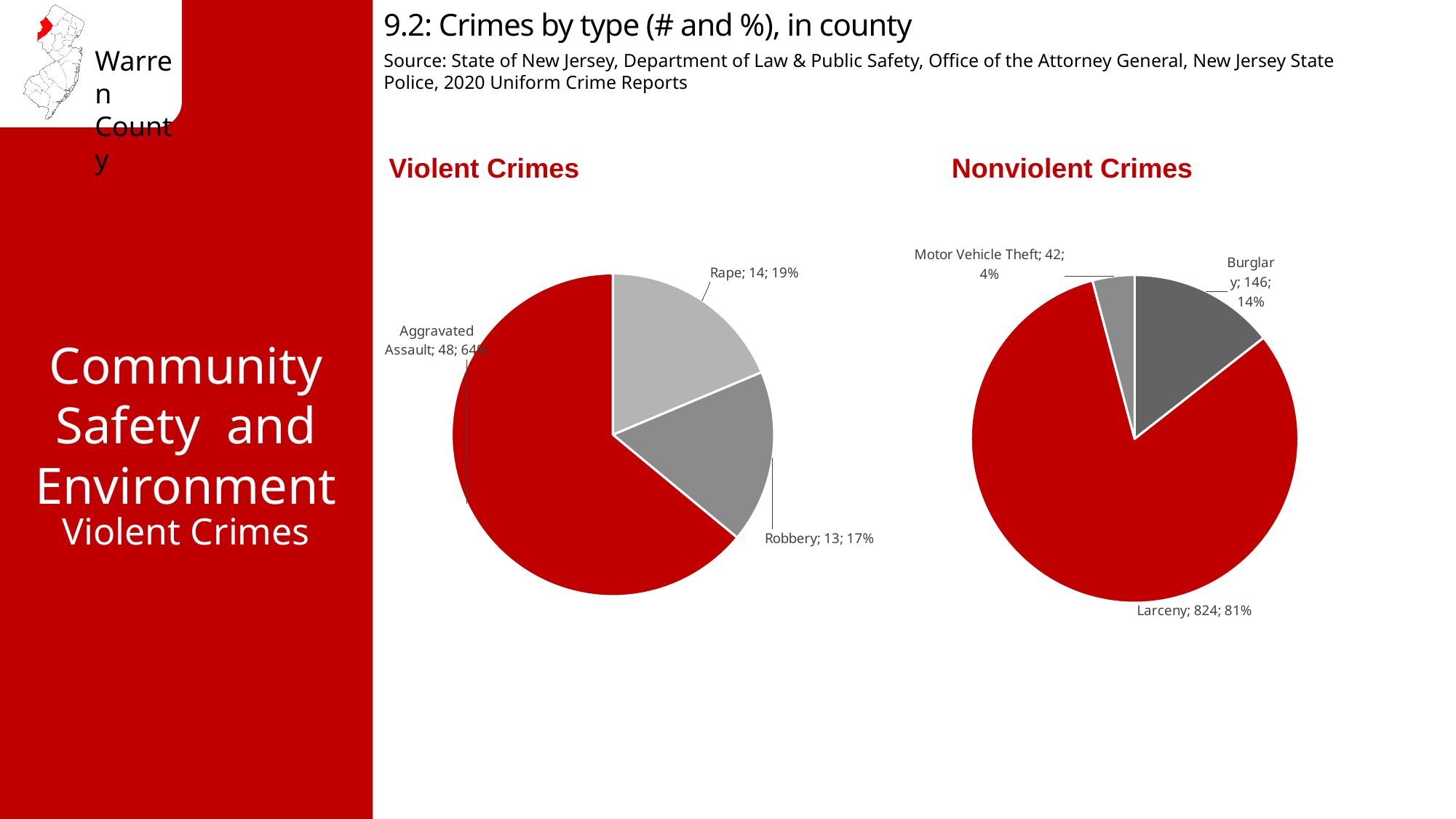
In the Nonviolent Crimes chart, which is larger, Burglary or Motor Vehicle Theft? Burglary What is the title of the chart on the right side of the slide? Nonviolent Crimes In the Nonviolent Crimes chart, what share of the pie is Burglary? 14% In the Violent Crimes chart, which category has the smallest slice? Robbery In the Nonviolent Crimes chart, which category has the largest slice? Larceny In the Nonviolent Crimes chart, what is the difference between the number of burglaries and the number of motor vehicle thefts? 104 In the Violent Crimes chart, what is the difference between the number of rapes and the number of robberies? 1 In the Nonviolent Crimes chart, how many larcenies are shown? 824 In the Violent Crimes chart, what share of the pie is Rape? 19% What kind of chart is the Violent Crimes chart? Pie chart In the Violent Crimes chart, how many categories are shown? 3 In the Violent Crimes chart, how many aggravated assaults are shown? 48